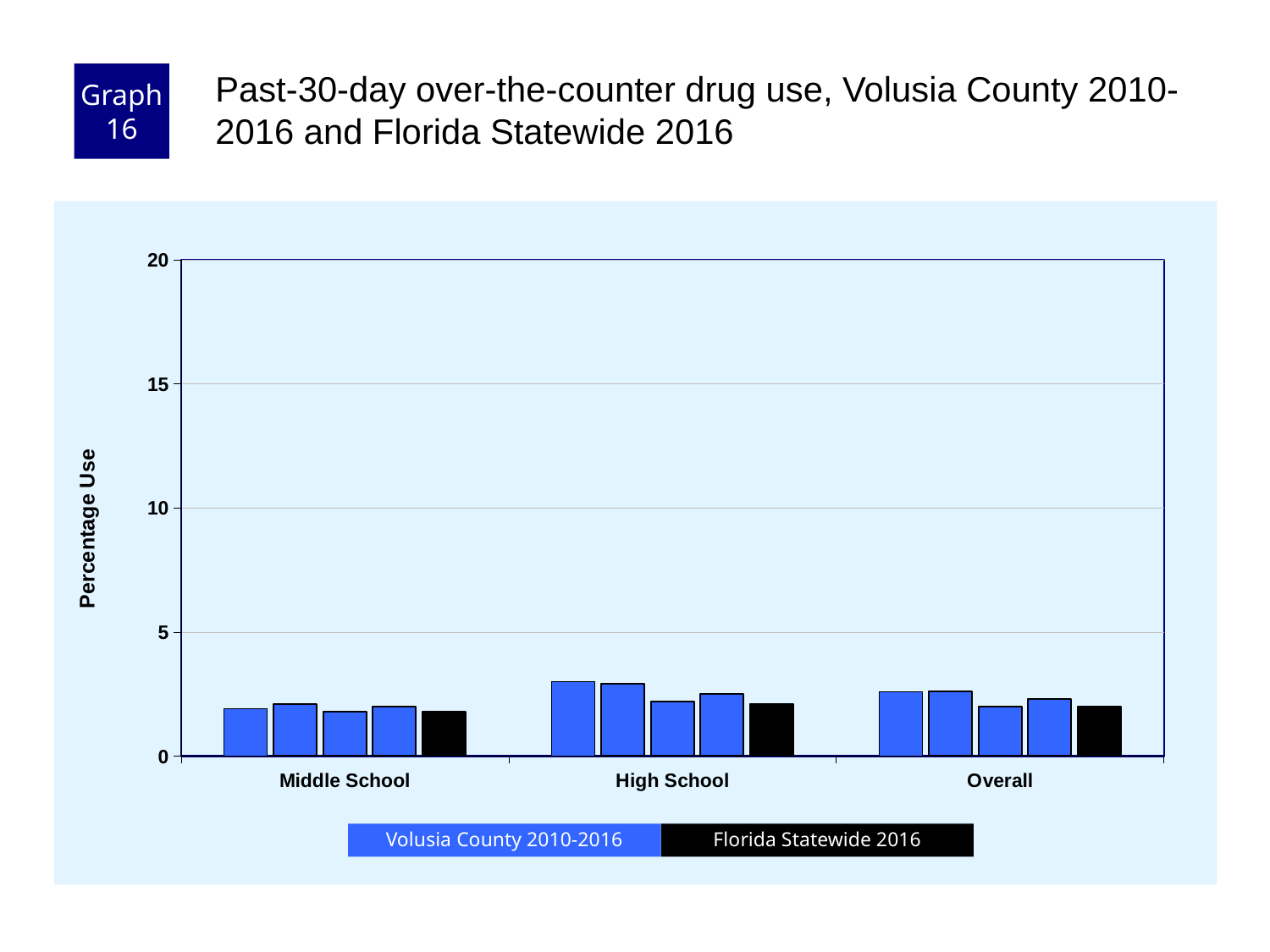
Is the value for Florida Statewide 2016 in the High School category greater or less than 5? less What is the maximum value shown on the y axis? 20 Is the value for Florida Statewide 2016 in the Overall category greater or less than 5? less Are any of the bars in the Middle School category greater or less than 5? less What is the label on the y axis? Percentage Use What kind of chart is shown on the slide? bar chart How many categories are shown on the x axis? 3 Is the tallest Volusia County bar in High School larger or smaller than the tallest Volusia County bar in Middle School? larger Which category has the tallest bars overall? High School How many series does the legend list? 2 What colour are the Florida Statewide 2016 bars? black